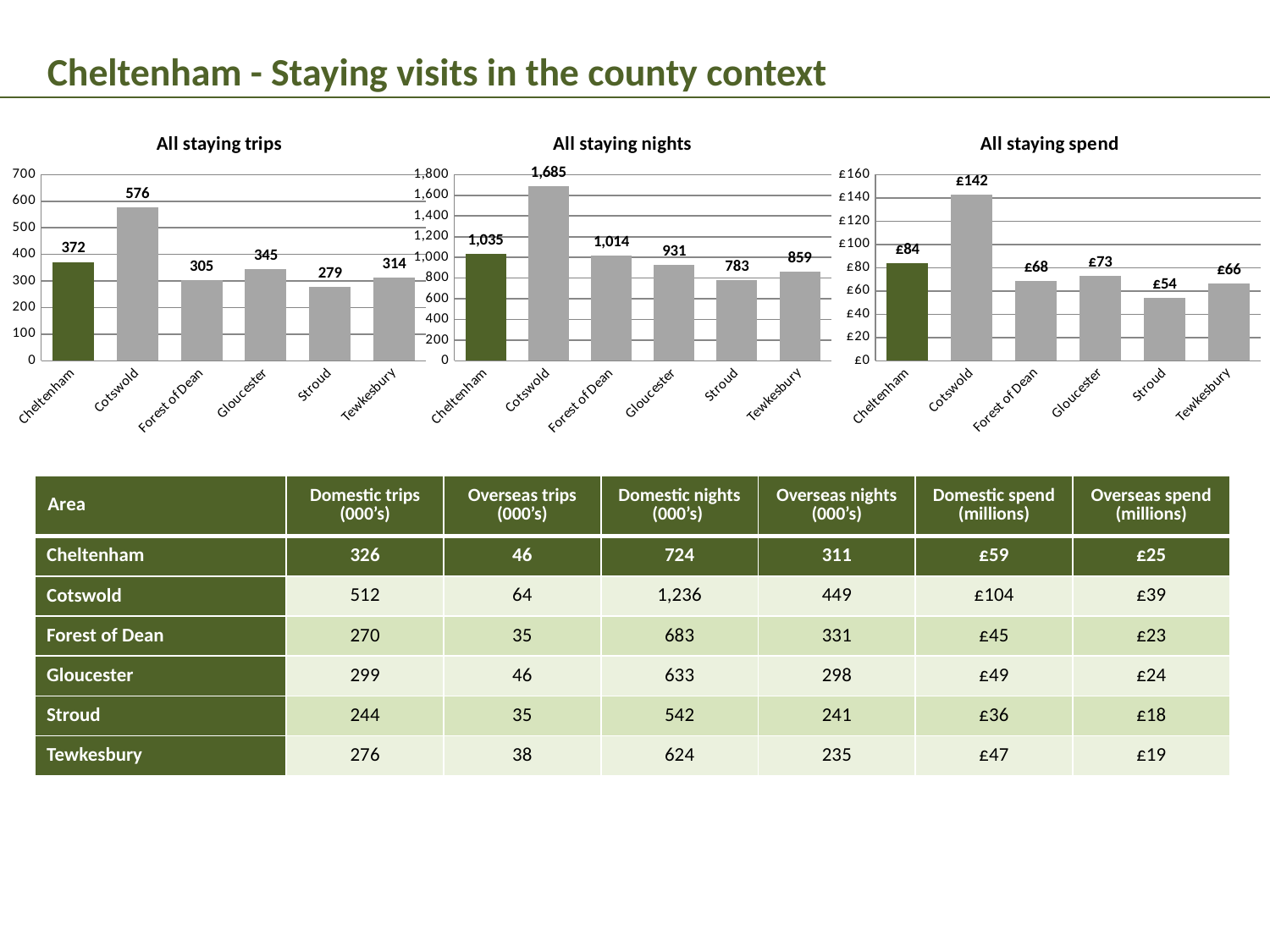
In the 'All staying trips' chart, which area has the lowest value? Stroud In the 'All staying spend' chart, which bar is coloured dark green rather than grey? Cheltenham How many areas are shown in the 'All staying trips' chart? 6 In the 'All staying spend' chart, what is the value for Stroud? £54 In the 'All staying trips' chart, which area has the highest value? Cotswold In the 'All staying nights' chart, what is the value for Gloucester? 931 In the 'All staying spend' chart, what is the difference between Cotswold and Cheltenham? £58 In the 'All staying nights' chart, what is the difference between Cotswold and Cheltenham? 650 In the 'All staying spend' chart, which area has the lowest value? Stroud What kind of chart is the 'All staying nights' chart? Bar chart In the 'All staying trips' chart, what is the value for Cheltenham? 372 In the 'All staying nights' chart, which is larger, Forest of Dean or Tewkesbury? Forest of Dean